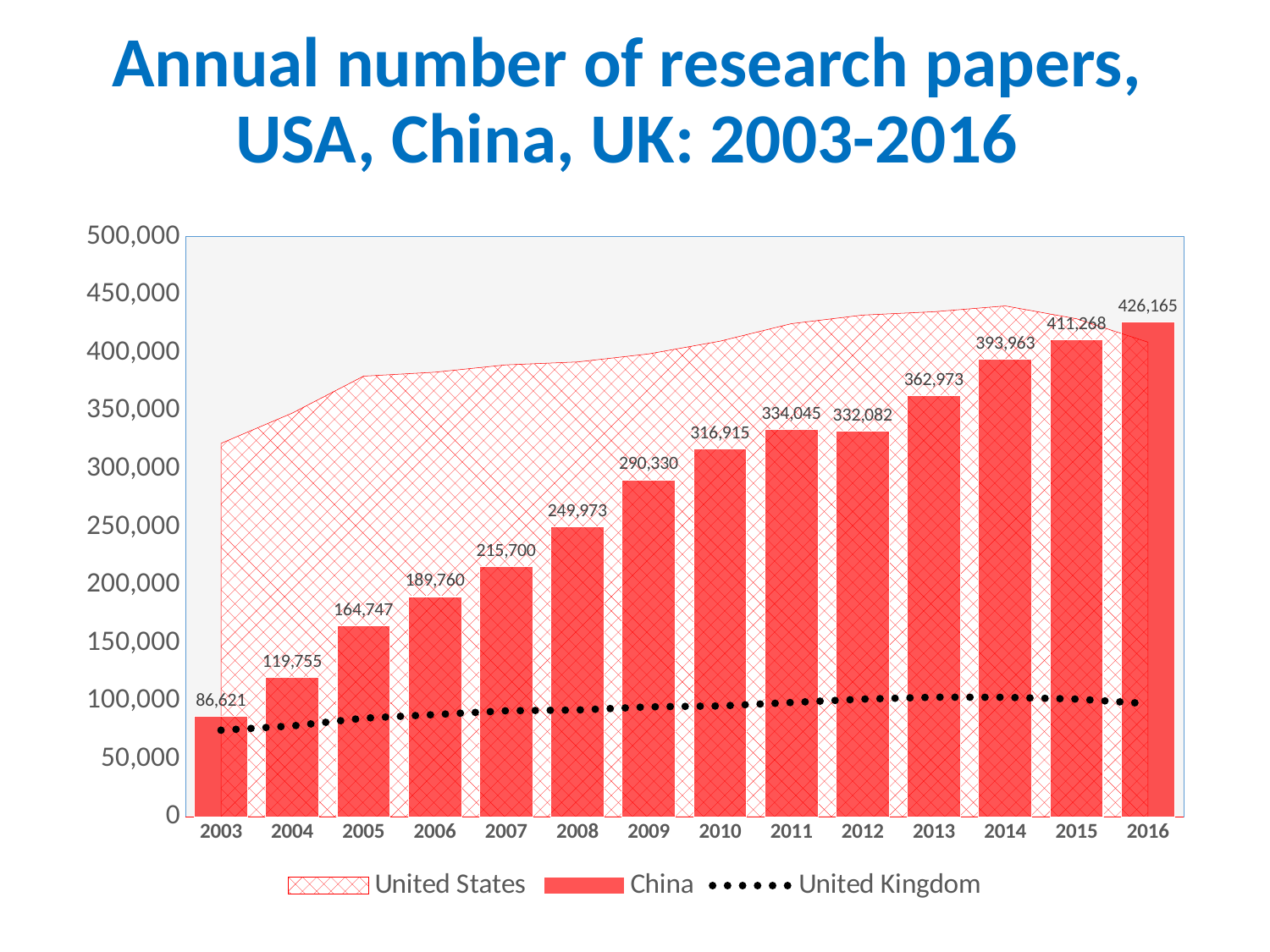
Is the value for the United States in 2003 greater or less than 300,000? greater What is the value for China in 2003? 86,621 Is the value for the United Kingdom in 2003 greater or less than 100,000? less What is the difference between the China values for 2016 and 2003? 339,544 In which year is the China value lowest? 2003 In which year is the China value highest? 2016 How many years are shown on the x axis? 14 How many series does the legend list? 3 What is the value for China in 2016? 426,165 What is the value for China in 2009? 290,330 Which is larger, the China value for 2011 or for 2012? 2011 Do the China values generally rise or fall from 2003 to 2016? rise